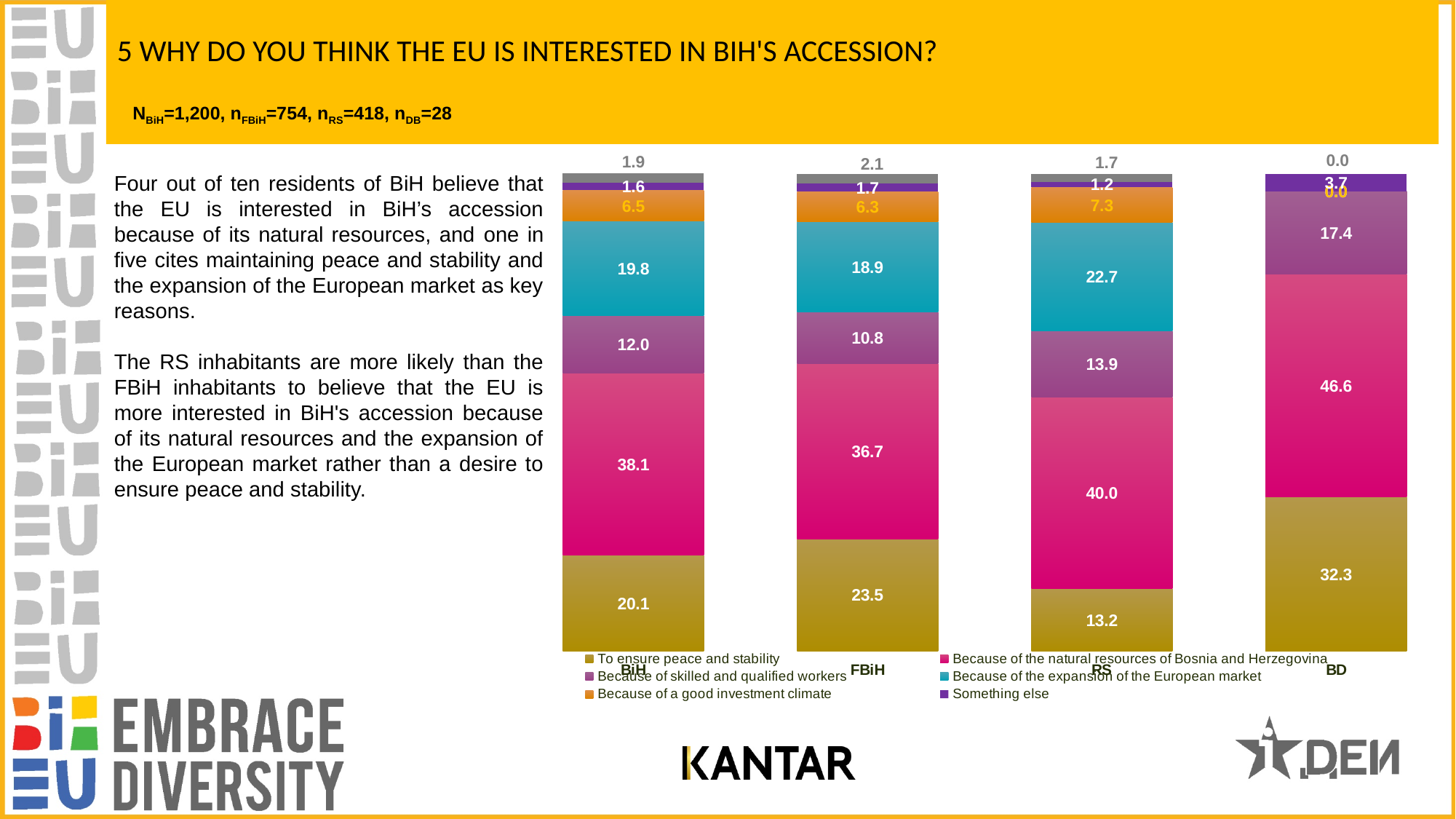
What kind of chart is shown on the slide? Stacked bar chart What is the value for 'Because of skilled and qualified workers' in the BD bar? 17.4 What is the value for 'To ensure peace and stability' in the RS bar? 13.2 Which legend entry is shown in pink? Because of the natural resources of Bosnia and Herzegovina Which is larger: the 'Because of the expansion of the European market' value for RS or for BiH? RS What is the difference between the RS and FBiH values for 'Because of the natural resources of Bosnia and Herzegovina'? 3.3 Which region has the highest value for 'Because of the natural resources of Bosnia and Herzegovina'? BD What is the value for 'Because of the expansion of the European market' in the FBiH bar? 18.9 How many series does the legend list? 6 Which region has the lowest value for 'To ensure peace and stability'? RS What percentage of BiH residents say the EU is interested because of the natural resources of Bosnia and Herzegovina? 38.1 How many regions (bars) are shown in the chart? 4